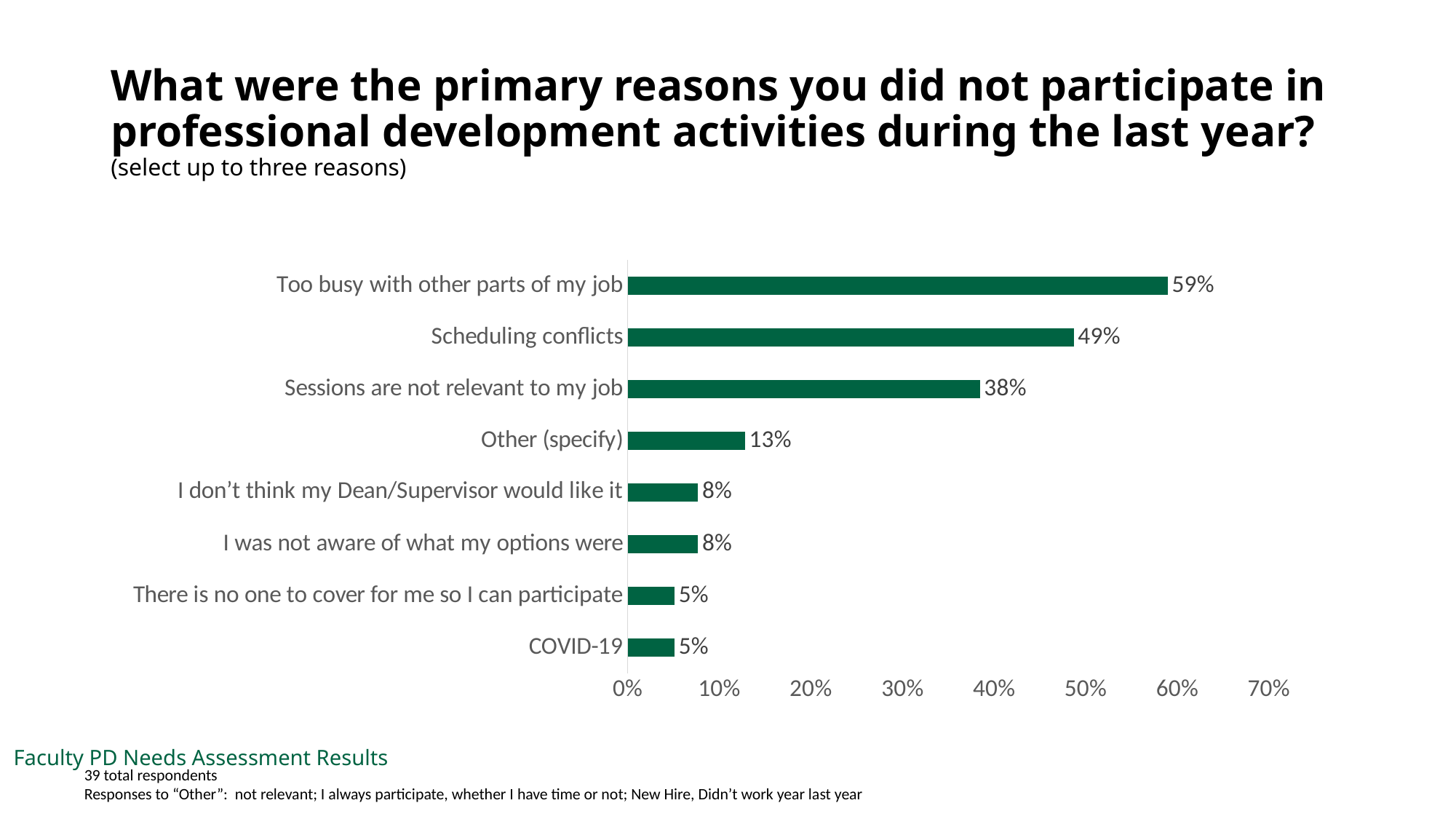
What percentage selected "Sessions are not relevant to my job"? 38% How many reasons (categories) are shown in the chart? 8 What is the difference between "Sessions are not relevant to my job" and "Other (specify)"? 25% What is the value for "Other (specify)"? 13% Which reason has the highest percentage? Too busy with other parts of my job What is the value for "COVID-19"? 5% Which is larger: "Scheduling conflicts" or "Sessions are not relevant to my job"? Scheduling conflicts What kind of chart is shown on the slide? Bar chart What is the difference between "Too busy with other parts of my job" and "Scheduling conflicts"? 10% What is the value for "Scheduling conflicts"? 49% What is the highest value shown on the percentage axis? 70% What percentage of respondents selected "Too busy with other parts of my job"? 59%